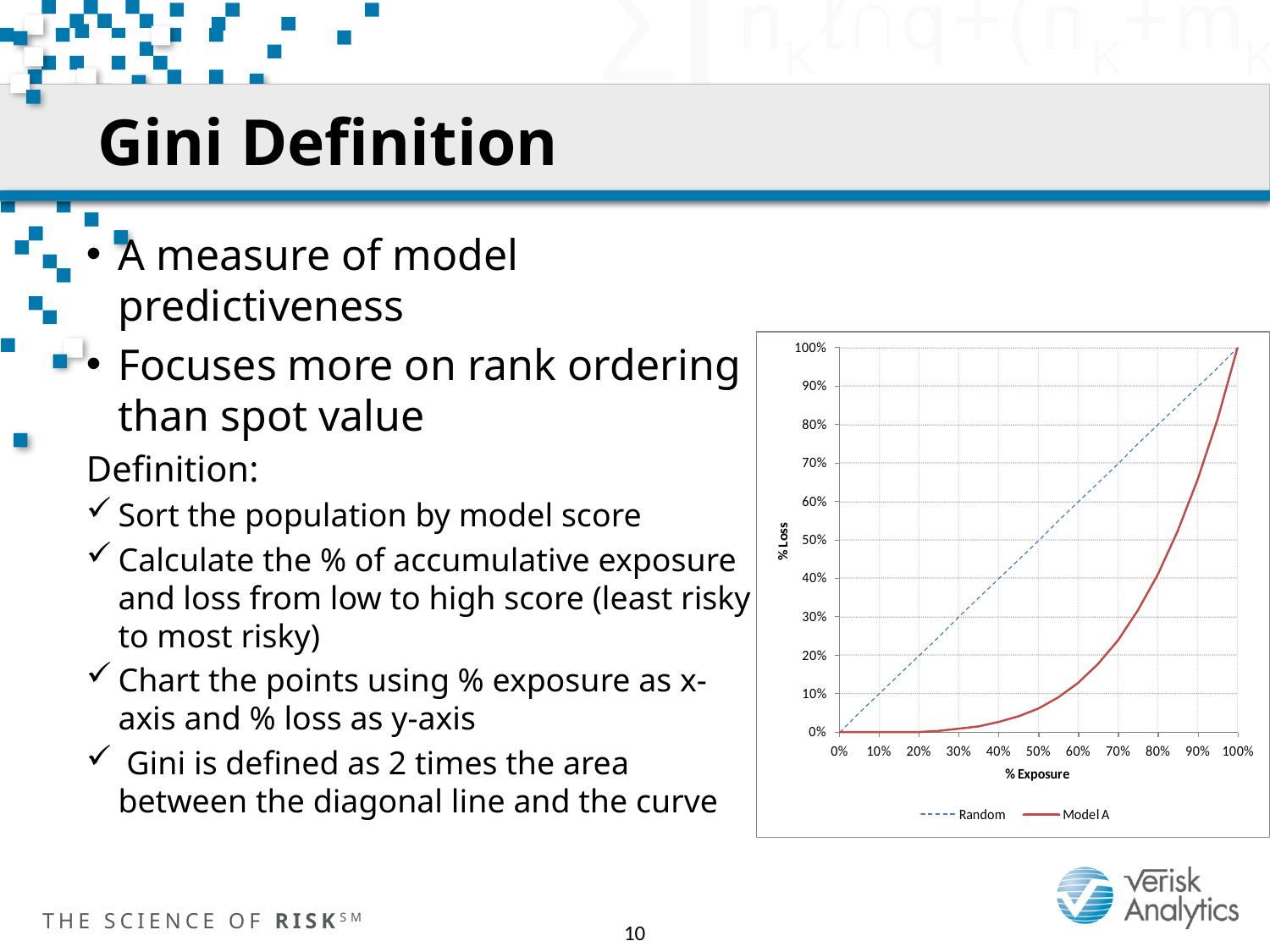
What is the % Loss value for Model A at 100% exposure? 100% Is the % Loss value for Model A at 90% exposure greater or less than 50%? greater What kind of chart is shown on the slide? line chart At 50% exposure, which series has the higher % Loss, Random or Model A? Random Is the % Loss value for Model A at 50% exposure greater or less than 20%? less How many series does the chart legend list? 2 What is the % Loss value for Model A at 0% exposure? 0% What is the label of the x axis of the chart? % Exposure Does the Model A curve rise or fall as % Exposure increases? rise Is the % Loss value for Model A at 70% exposure greater or less than 10%? greater What are the two series named in the chart legend? Random and Model A What is the % Loss value for Random at 50% exposure? 50%